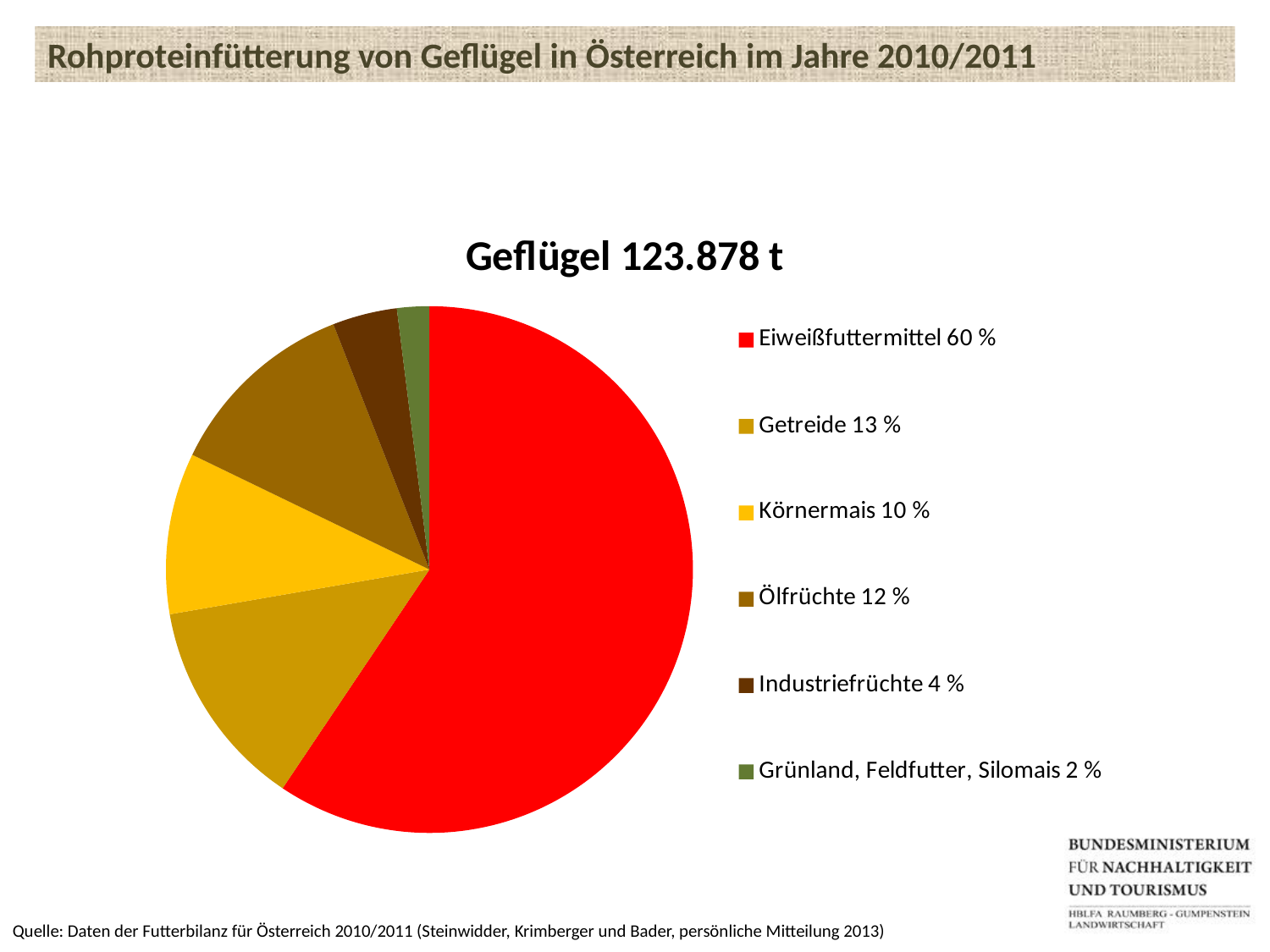
What share of the pie does Körnermais have? 10 % What is the chart's title? Geflügel 123.878 t What share of the pie does Eiweißfuttermittel have? 60 % What share of the pie does Grünland, Feldfutter, Silomais have? 2 % What is the difference in percentage points between Getreide and Industriefrüchte? 9 % Which category has the smallest slice of the pie? Grünland, Feldfutter, Silomais How many categories does the legend list? 6 Which category has the largest slice of the pie? Eiweißfuttermittel Which is larger, the share for Ölfrüchte or the share for Körnermais? Ölfrüchte What kind of chart is shown on the slide? pie chart